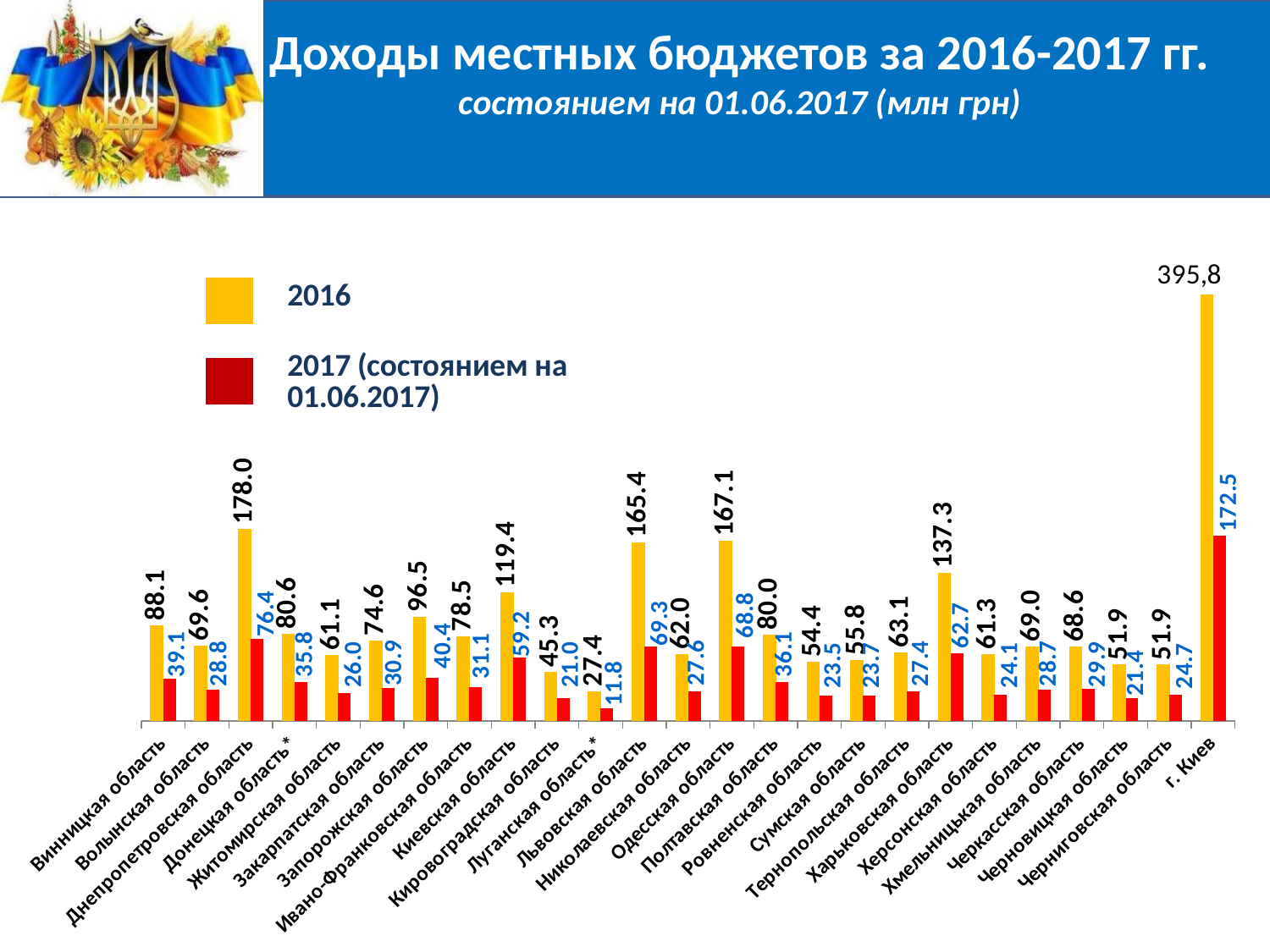
How many series does the legend list? 2 Which category has the lowest 2017 value? Луганская область* What type of chart is shown on the slide? bar chart What is the 2017 value for Харьковская область? 62.7 How many regions (categories) are shown on the x axis? 25 What colour are the bars for the 2016 series? yellow What is the difference between the 2016 and 2017 values for Днепропетровская область? 101.6 Which has the larger 2016 value, Харьковская область or Киевская область? Харьковская область Which category has the highest 2016 value? г. Киев What is the 2016 value for Днепропетровская область? 178.0 What is the 2016 value for г. Киев? 395,8 What is the difference between the 2016 and 2017 values for г. Киев? 223.3